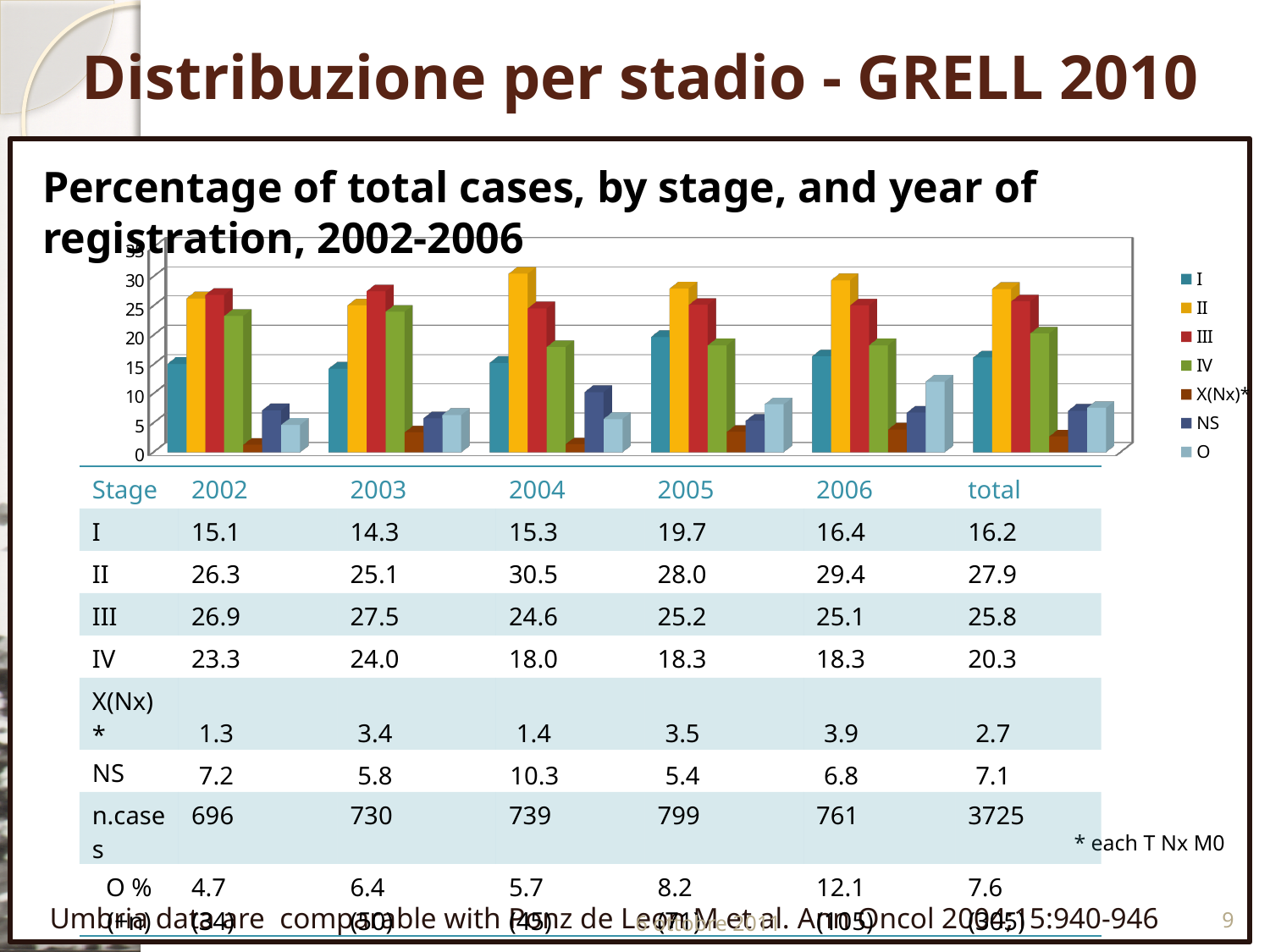
How many series does the chart legend list? 7 What kind of chart is shown on the slide? bar chart Is the value for stage IV in 2002 greater or less than 20? greater Which stage has the shortest bar in the 2002 group? X(Nx)* Which is larger in 2003: the stage III percentage or the stage IV percentage? stage III What is the difference between the stage II and stage I percentages in 2004? 15.2 How many groups of bars (years plus total) are plotted on the chart? 6 What is the percentage for stage II in 2004? 30.5 What is the total number of cases (n.cases) across 2002-2006? 3725 What is the total percentage for stage III across 2002-2006? 25.8 What is the percentage for stage I in 2005? 19.7 Which stage has the tallest bar in the 2004 group? II